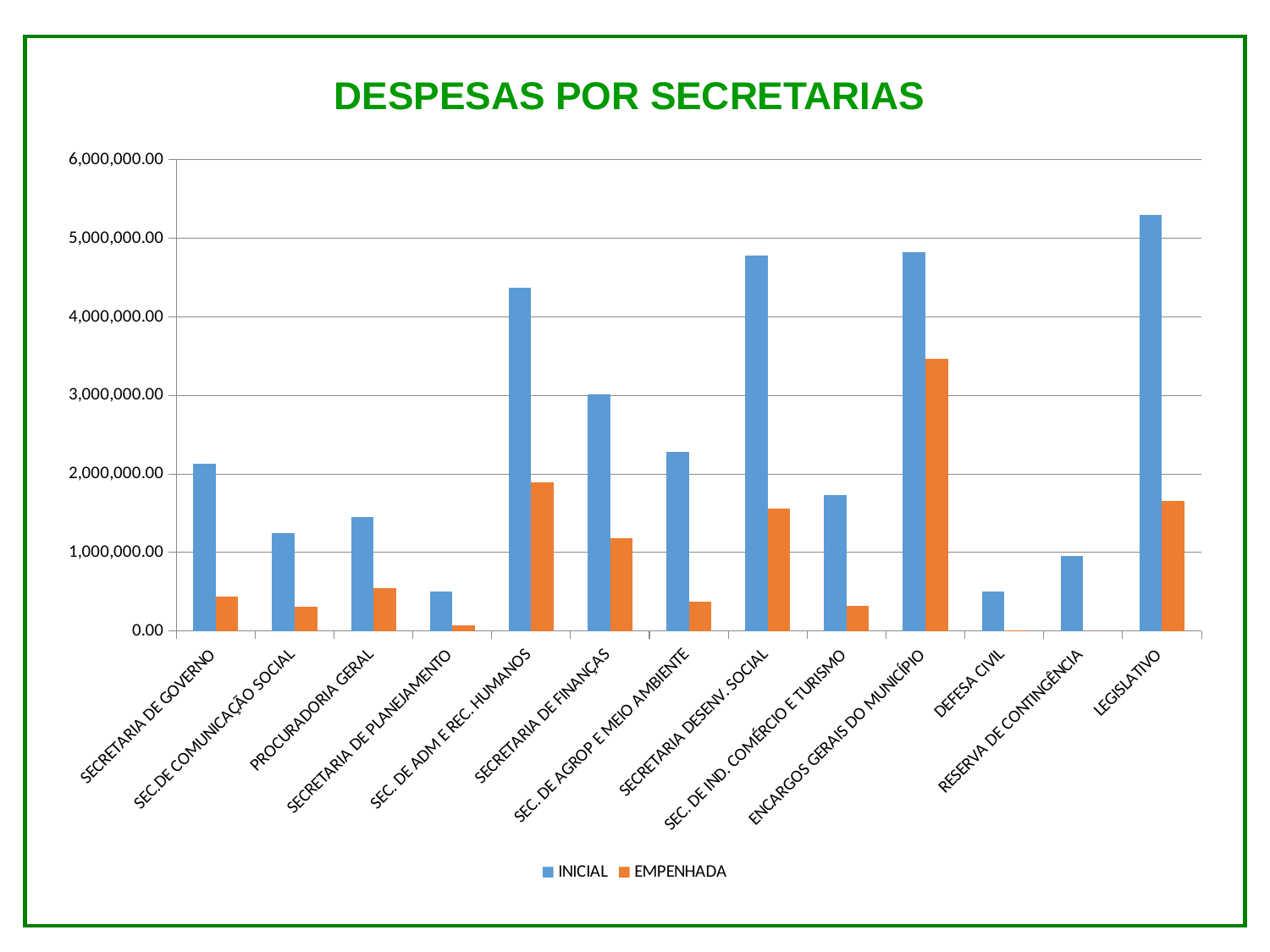
Which category has the highest EMPENHADA value? ENCARGOS GERAIS DO MUNICÍPIO Which has the larger EMPENHADA value, SEC. DE ADM E REC. HUMANOS or LEGISLATIVO? SEC. DE ADM E REC. HUMANOS Is the INICIAL value for SECRETARIA DE GOVERNO greater or less than 3,000,000.00? less Is the INICIAL value for SECRETARIA DESENV. SOCIAL greater or less than 4,000,000.00? greater Is the EMPENHADA value for ENCARGOS GERAIS DO MUNICÍPIO greater or less than 3,000,000.00? greater Which has the larger INICIAL value, PROCURADORIA GERAL or SEC.DE COMUNICAÇÃO SOCIAL? PROCURADORIA GERAL How many series does the legend list? 2 What kind of chart is shown on the slide? bar chart How many categories are shown on the x axis? 13 Which category has the highest INICIAL value? LEGISLATIVO What is the title of the chart? DESPESAS POR SECRETARIAS